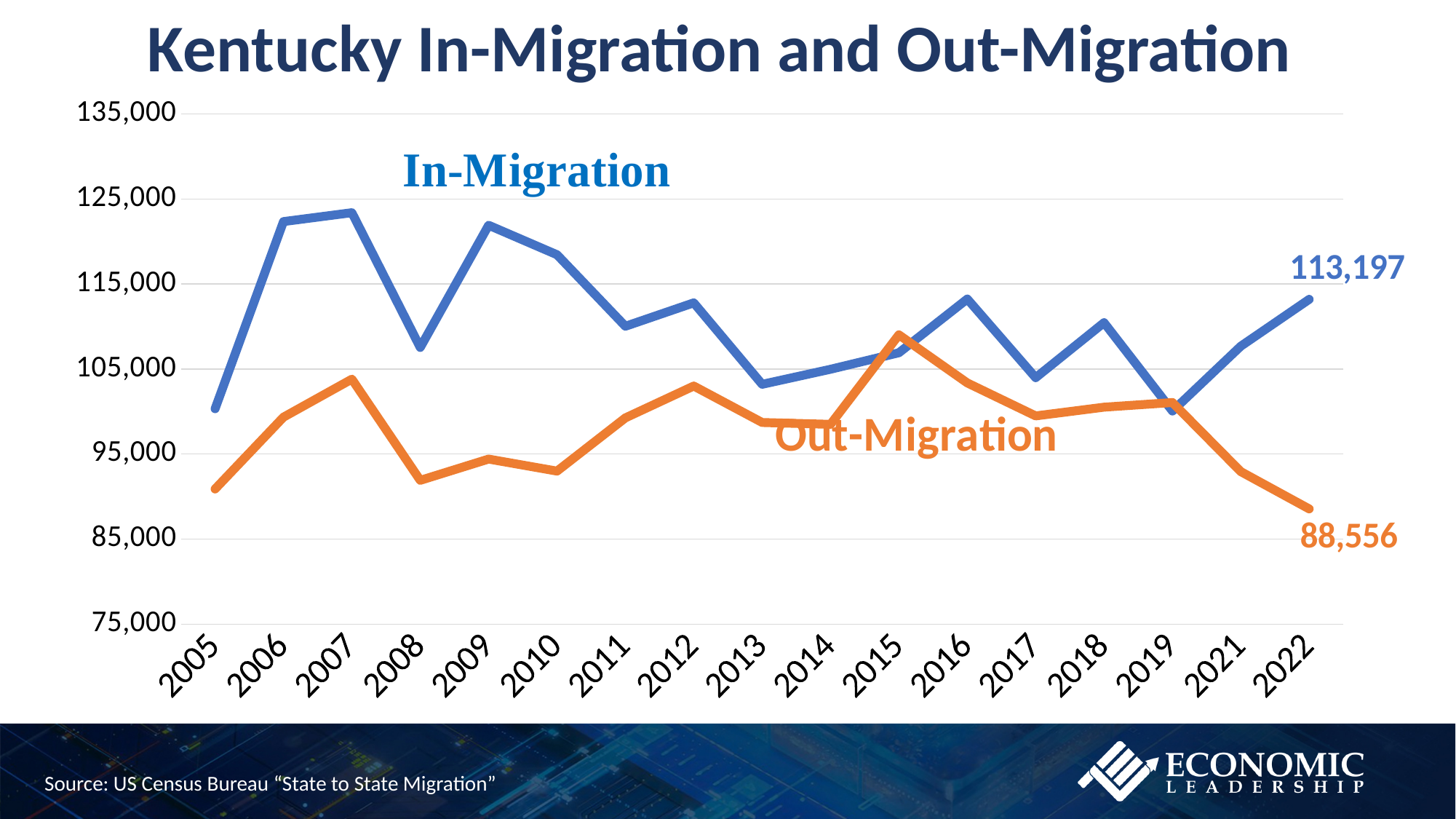
Which year has the lowest Out-Migration value? 2022 In 2022, which is larger, In-Migration or Out-Migration? In-Migration How many years are shown on the x axis? 17 Is the In-Migration value for 2005 greater or less than 105,000? less What is the Out-Migration value for 2022? 88,556 What is the difference between In-Migration and Out-Migration in 2022? 24,641 How many series are plotted on the chart? 2 What colour is the In-Migration line? Blue In 2015, which is larger, In-Migration or Out-Migration? Out-Migration What is the In-Migration value for 2022? 113,197 Does Out-Migration rise or fall from 2019 to 2022? fall What kind of chart is shown on the slide? Line chart